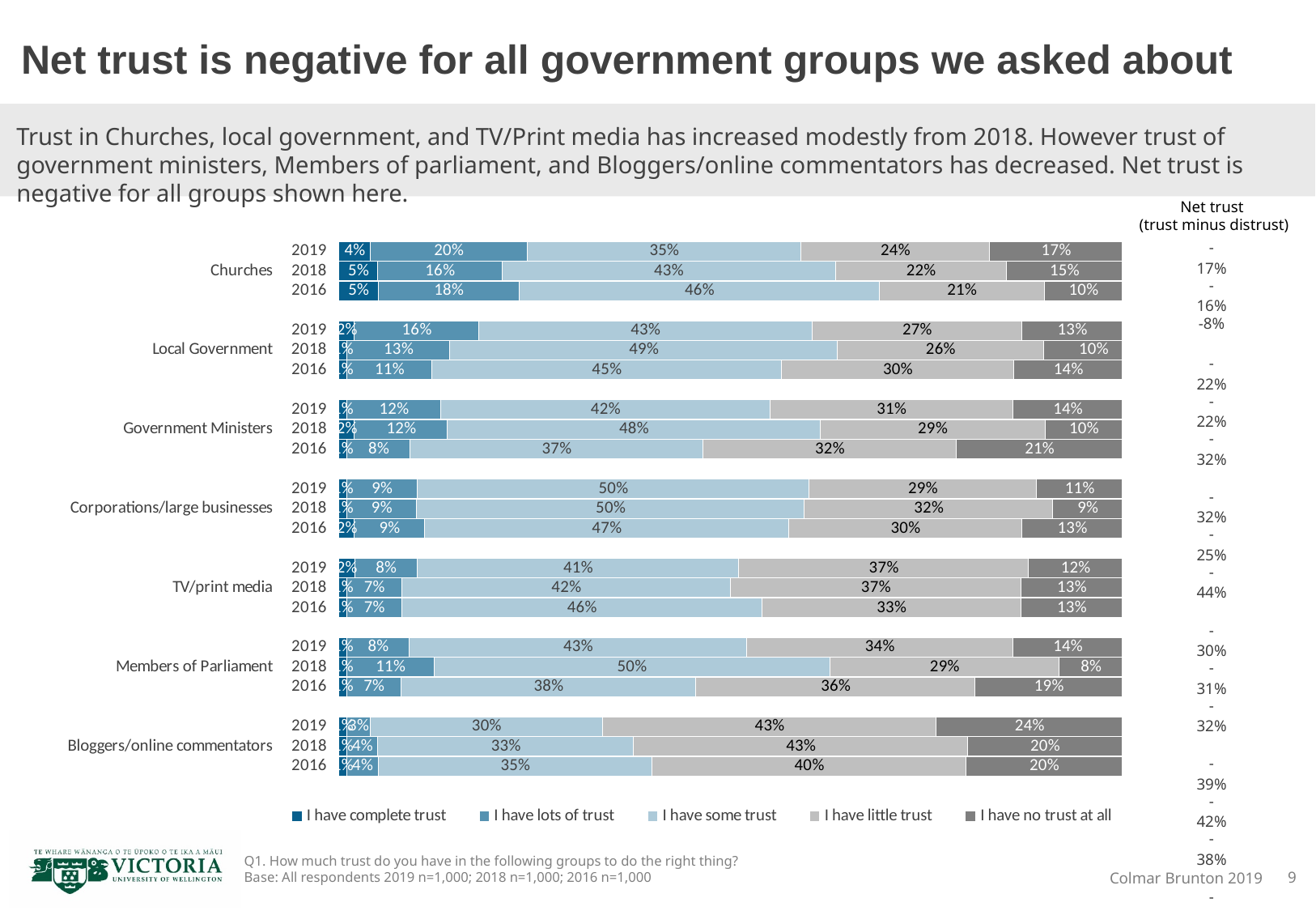
What kind of chart is shown on the slide? Stacked bar chart Among the 2019 bars, which group has the lowest 'I have some trust' value? Bloggers/online commentators How many series does the legend list? 5 Which legend entry is shown in the darkest blue colour? I have complete trust What percentage of respondents said they have no trust at all in Bloggers/online commentators in 2019? 24% How many groups (categories) are shown on the chart? 7 Which is larger: the 'I have no trust at all' value for Government Ministers in 2016 or in 2019? 2016 Among the 2019 bars, which group has the highest 'I have no trust at all' value? Bloggers/online commentators What is the difference between the 'I have some trust' values for Churches in 2016 and 2019? 11% What percentage of respondents said they have some trust in Churches in 2019? 35% What percentage of respondents said they have little trust in TV/print media in 2018? 37% What percentage of respondents said they have lots of trust in Local Government in 2019? 16%